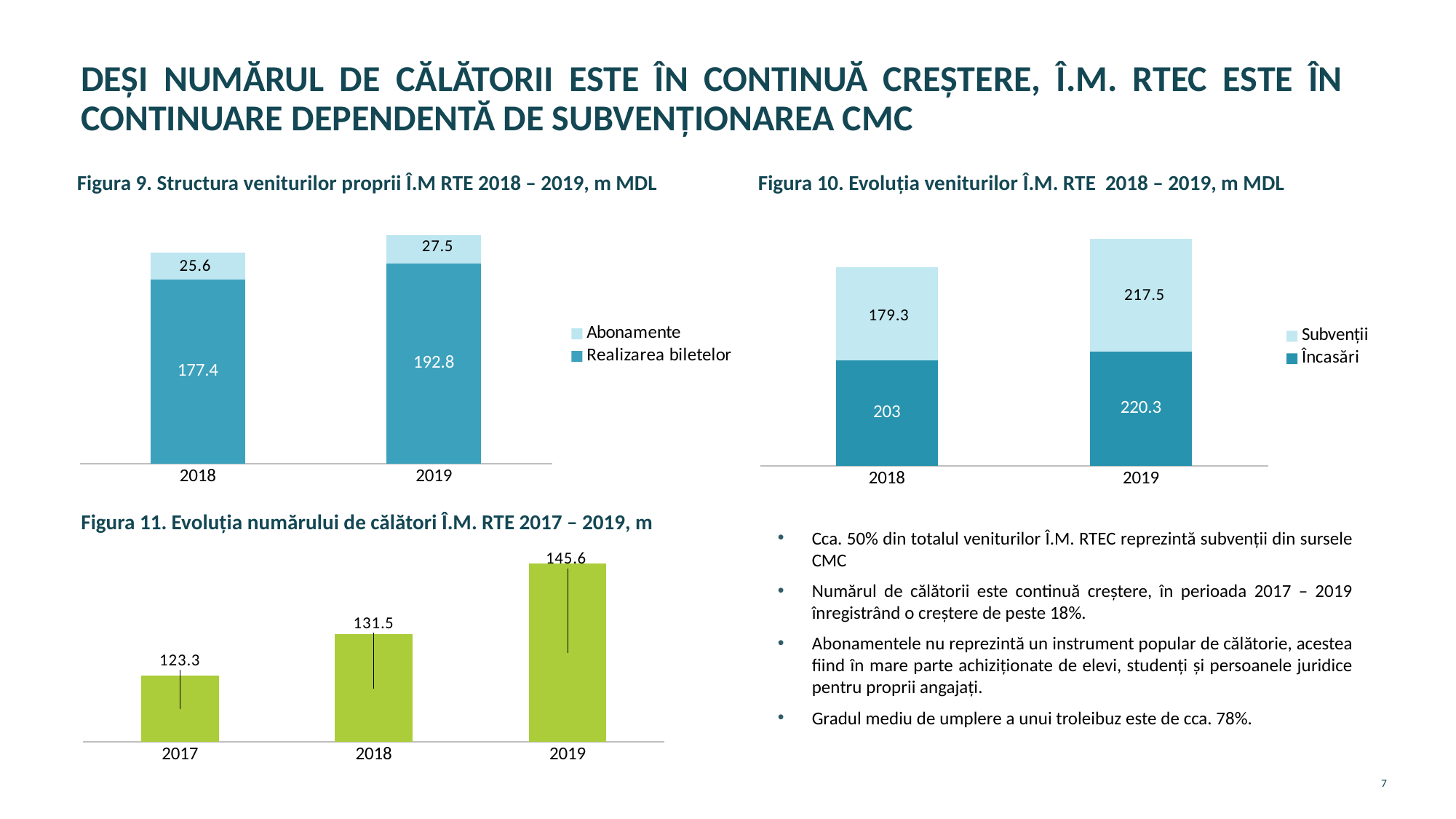
In Figura 11, what is the value for 2018? 131.5 In Figura 9, what is the value of Abonamente for 2018? 25.6 In Figura 10, what is the total of the stacked bar for 2019? 437.8 In Figura 11, which year has the highest value? 2019 In Figura 10, what is the value of Încasări for 2018? 203 In Figura 11, do the values rise or fall from 2017 to 2019? rise In Figura 9, how many series does the legend list? 2 In Figura 9, what is the value of Realizarea biletelor for 2019? 192.8 In Figura 10, which is larger for 2018, Încasări or Subvenții? Încasări In Figura 9, what is the total of the stacked bar for 2018? 203.0 In Figura 11, what is the difference between the values for 2019 and 2017? 22.3 In Figura 10, what is the value of Subvenții for 2019? 217.5